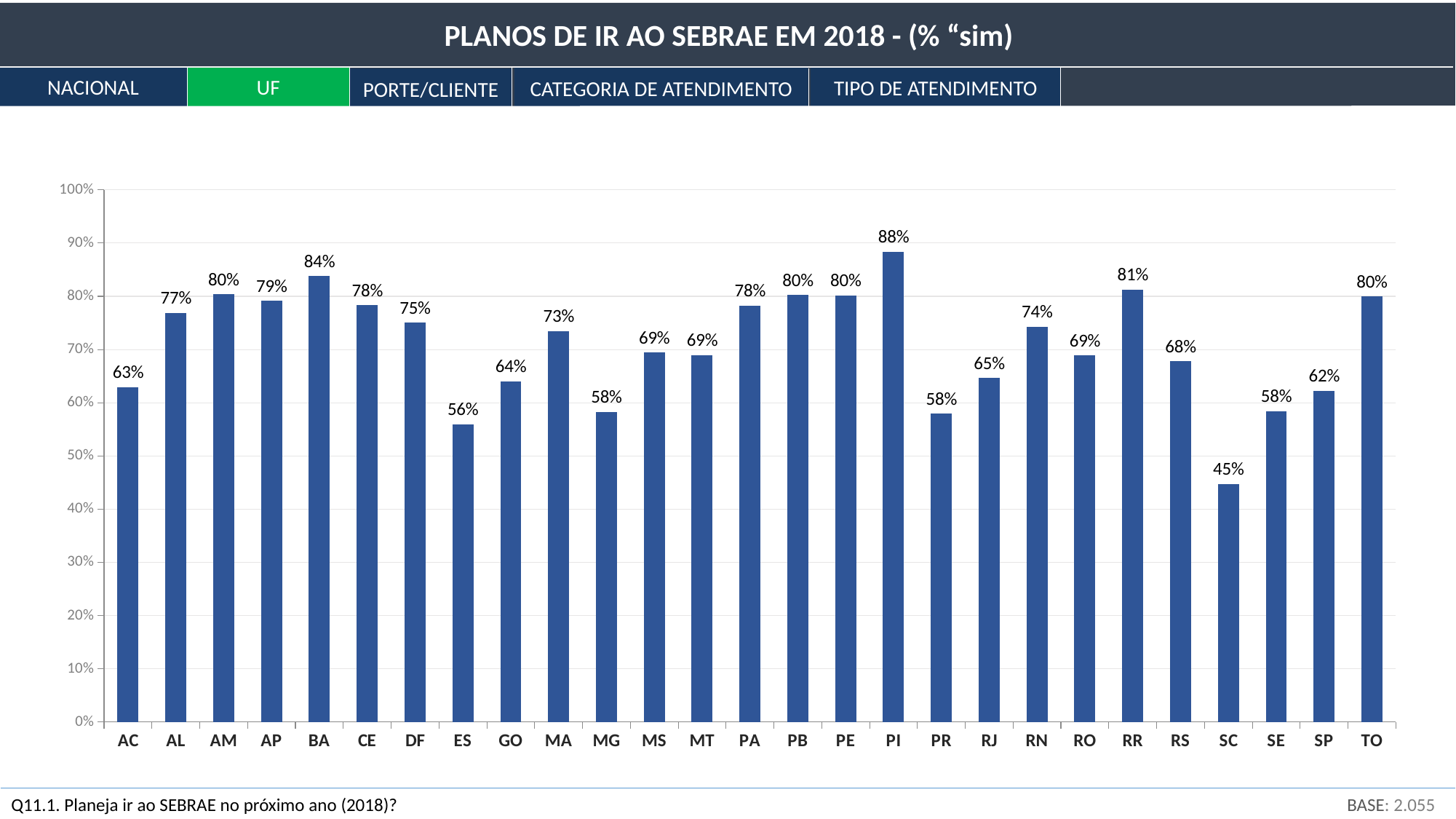
What is the value for SC? 45% What is the value for SP? 62% What is the title of the chart? PLANOS DE IR AO SEBRAE EM 2018 - (% "sim") Which is larger, the value for RR or the value for RS? RR What kind of chart is shown on the slide? Bar chart What is the value for PI? 88% What is the value for BA? 84% What is the difference between the values for PI and SC? 43% Which UF has the highest value? PI Which UF has the lowest value? SC How many UFs are shown on the x axis? 27 What is the difference between the values for BA and ES? 28%